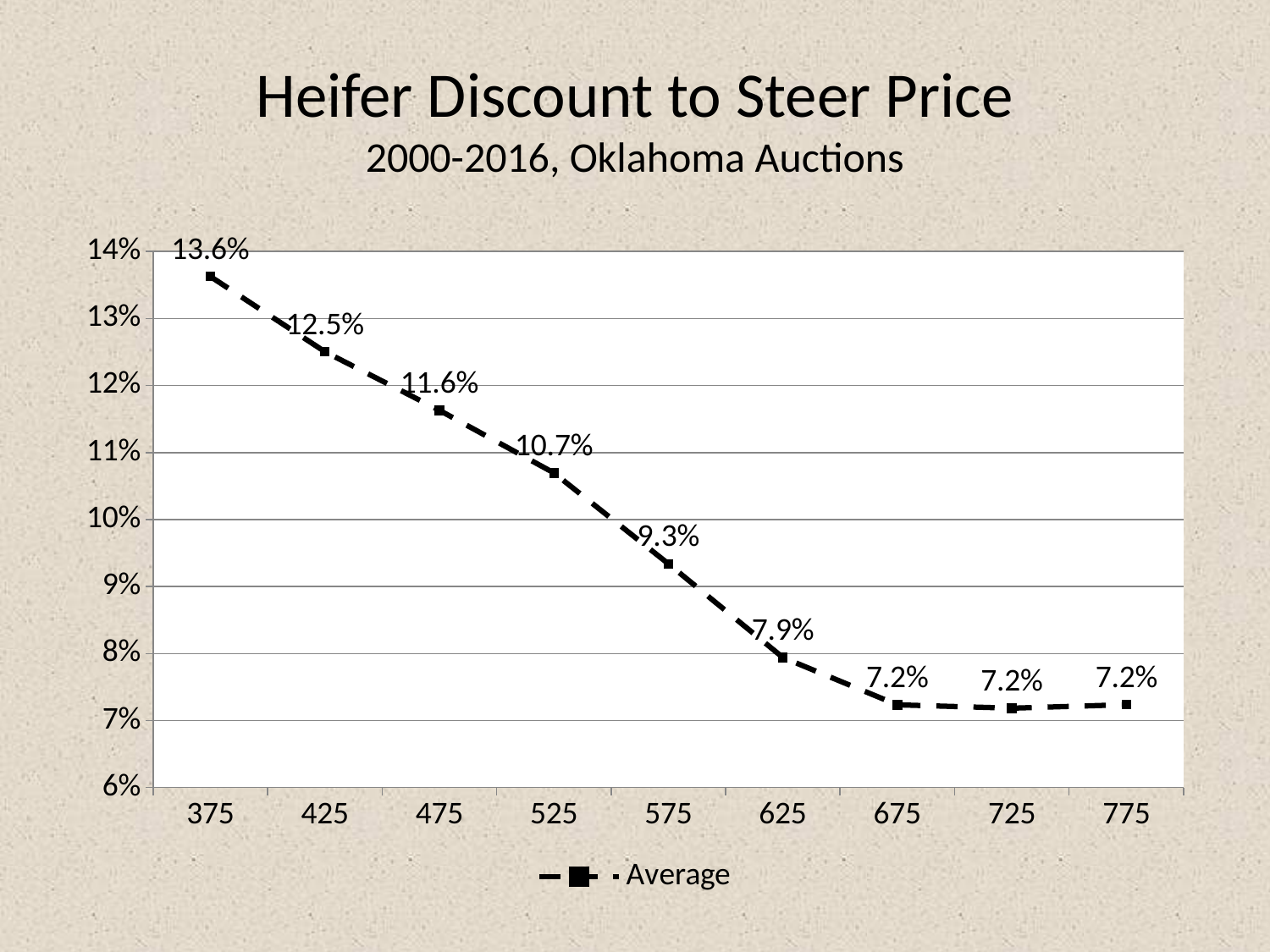
Which weight category has the highest average heifer discount? 375 What is the average heifer discount at the 525 weight category? 10.7% What kind of chart is shown on the slide? line chart What is the average heifer discount at the 375 weight category? 13.6% Do the average discount values rise or fall as weight increases from 375 to 675? fall What is the average heifer discount at the 625 weight category? 7.9% What is the difference between the average discount at 575 and at 625? 1.4% Which is larger, the average discount at 475 or at 575? 475 Is the average discount at 525 greater or less than 10%? greater How many series does the legend list? 1 How many weight categories are plotted on the x axis? 9 What is the difference between the average discount at 375 and at 425? 1.1%